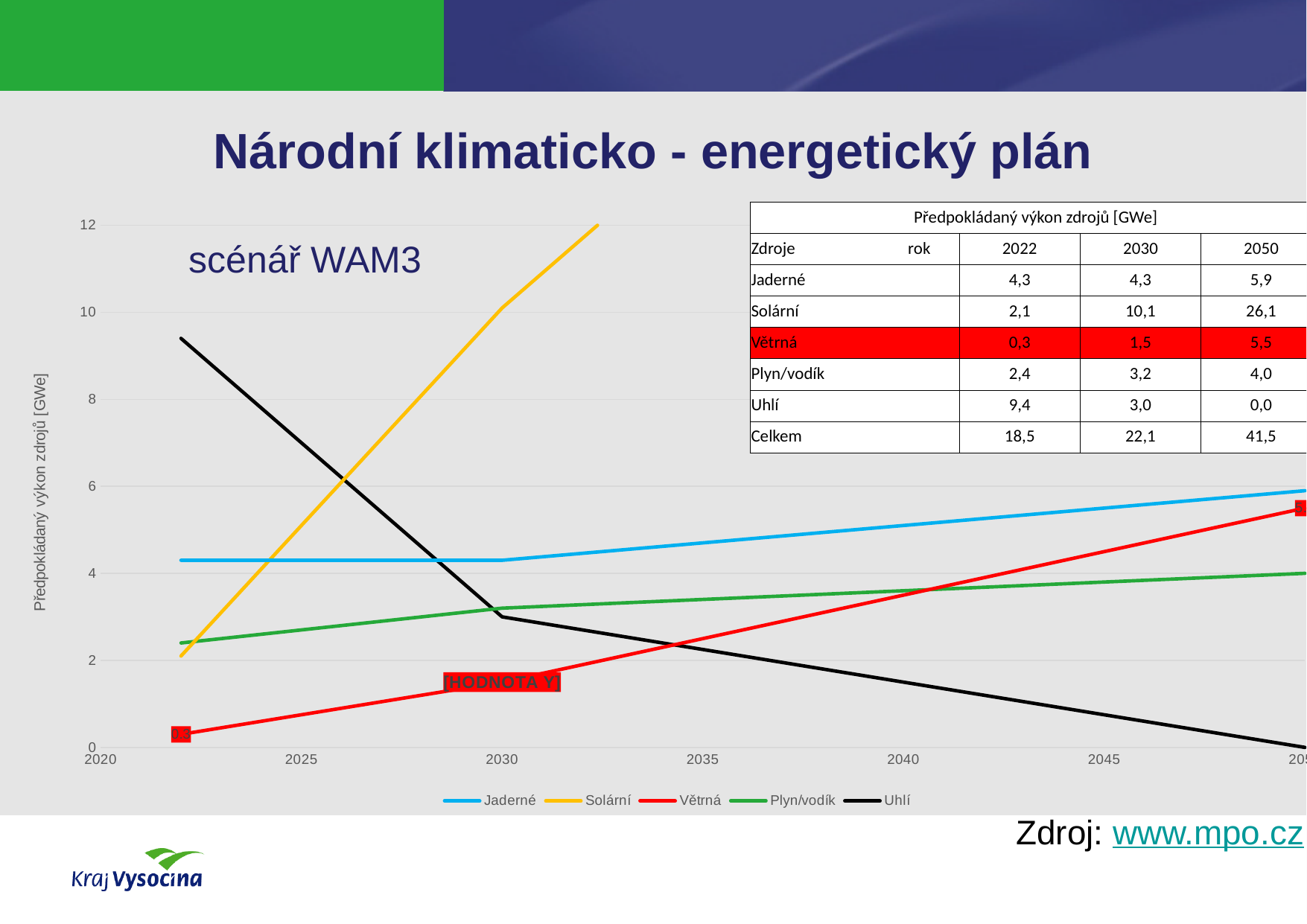
Is the value for Jaderné in 2050 greater or less than 6? less How many series does the chart legend list? 5 Which series has the highest value in 2022? Uhlí What is the label of the y axis? Předpokládaný výkon zdrojů [GWe] Which series has the lowest value in 2022? Větrná Does the Solární line rise or fall along the x axis? rise What is the data label shown on the Větrná line at 2022? 0,3 What kind of chart is shown on the slide? line chart Is the value for Uhlí in 2022 greater or less than 8? greater In 2022, which is larger: the value for Jaderné or the value for Plyn/vodík? Jaderné Is the value for Solární in 2030 greater or less than 10? greater Does the Uhlí line rise or fall from 2020 to 2050? fall